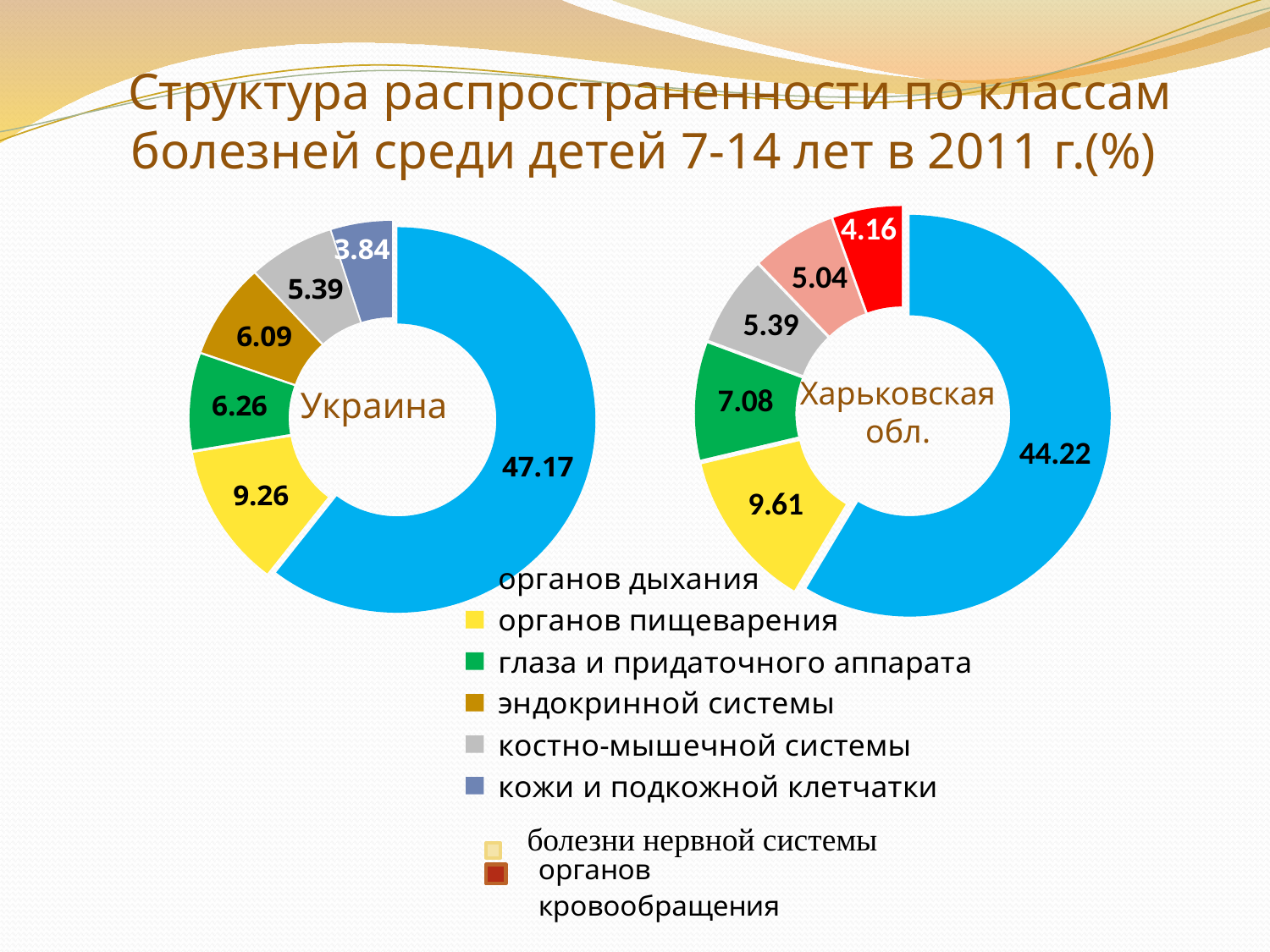
In the Украина chart, what is the value for эндокринной системы? 6.09 In the Харьковская обл. chart, what is the value for глаза и придаточного аппарата? 7.08 In the Харьковская обл. chart, what is the value for органов кровообращения? 4.16 What type of chart is used on this slide? Doughnut (pie) chart In the Украина chart, what is the value for органов дыхания? 47.17 In the Украина chart, which disease class has the largest share? органов дыхания In the Харьковская обл. chart, what is the value for органов дыхания? 44.22 In the Украина chart, which disease class has the smallest share? кожи и подкожной клетчатки What is the difference between the органов дыхания value in the Украина chart and in the Харьковская обл. chart? 2.95 In the Украина chart, what is the difference between органов пищеварения and глаза и придаточного аппарата? 3.00 How many slices does the Украина chart have? 6 Which chart shows a larger value for органов пищеварения, Украина or Харьковская обл.? Харьковская обл.